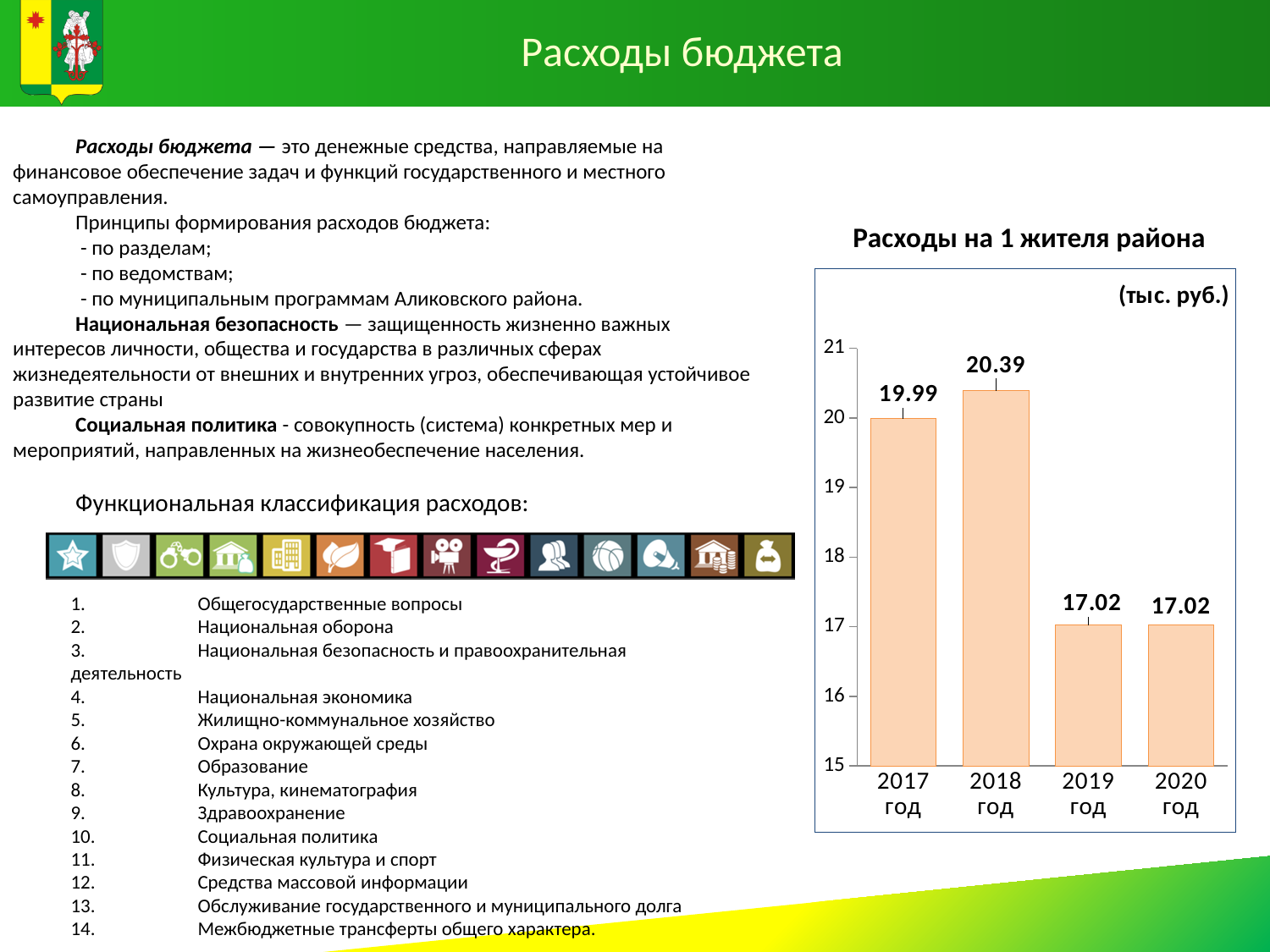
Do the values in the chart 'Расходы на 1 жителя района' rise or fall from 2018 год to 2020 год? fall What kind of chart is 'Расходы на 1 жителя района'? bar chart Which is larger in the chart 'Расходы на 1 жителя района': the value for 2017 год or 2018 год? 2018 год What is the difference between the values for 2018 год and 2017 год in the chart 'Расходы на 1 жителя района'? 0.40 Is the value for 2019 год in the chart 'Расходы на 1 жителя района' greater or less than 18? less What is the difference between the values for 2018 год and 2019 год in the chart 'Расходы на 1 жителя района'? 3.37 What is the value for 2020 год in the chart 'Расходы на 1 жителя района'? 17.02 What is the value for 2018 год in the chart 'Расходы на 1 жителя района'? 20.39 What unit is indicated for the values in the chart 'Расходы на 1 жителя района'? тыс. руб. How many years are shown in the chart 'Расходы на 1 жителя района'? 4 What is the value for 2017 год in the chart 'Расходы на 1 жителя района'? 19.99 Which year has the highest value in the chart 'Расходы на 1 жителя района'? 2018 год